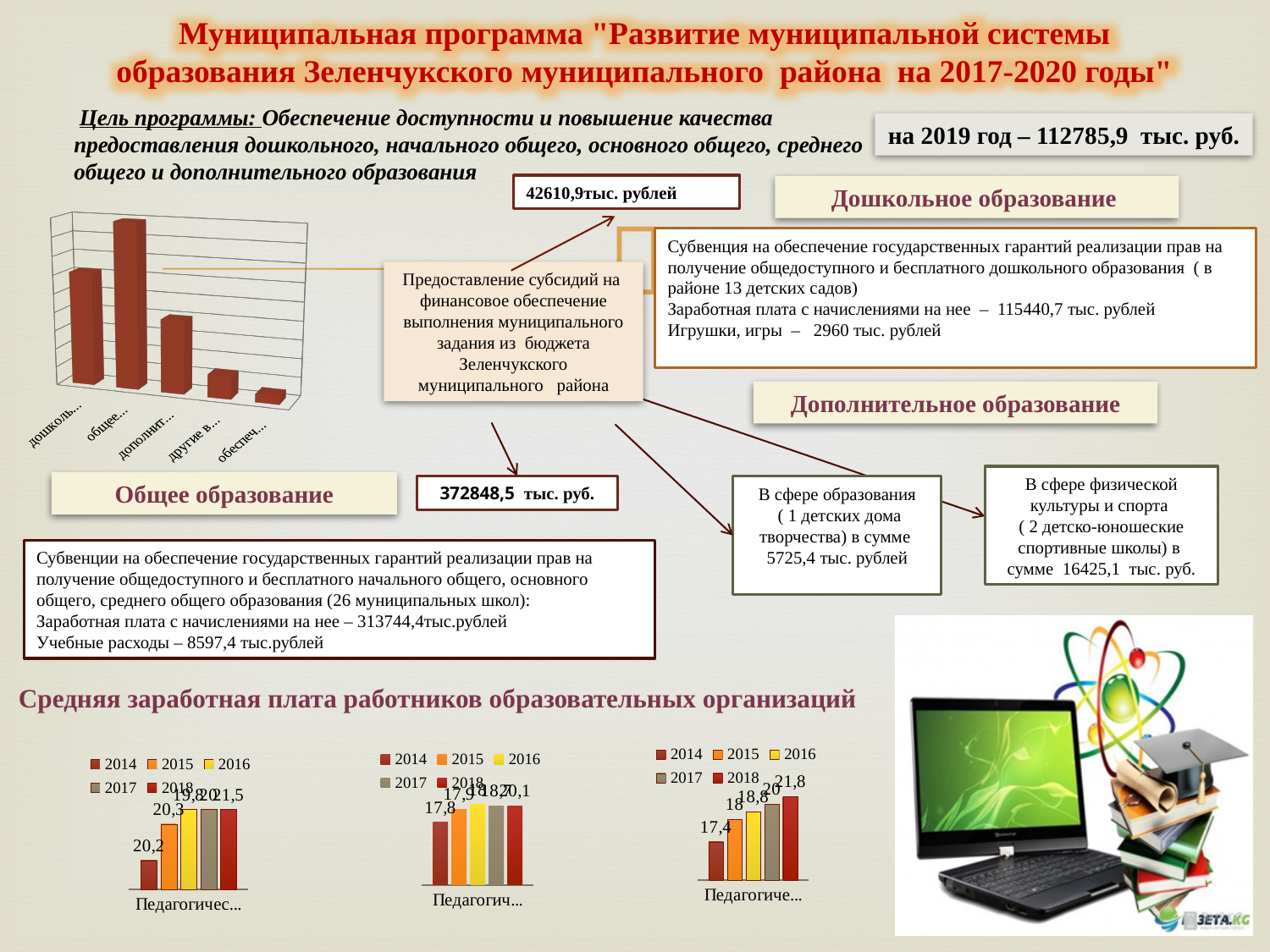
In the bottom-right small chart (third chart under 'Средняя заработная плата'), what is the value for 2018? 21,8 What is the heading printed above the three small bar charts at the bottom of the slide? Средняя заработная плата работников образовательных организаций In the bottom-right small chart (third chart under 'Средняя заработная плата'), which year has the highest value? 2018 How many series does the legend list in the bottom-right small chart (the third chart under 'Средняя заработная плата')? 5 In the large chart at the top left of the slide, is the second bar taller or shorter than the first bar? taller In the bottom-right small chart (third chart under 'Средняя заработная плата'), do the values rise or fall from 2014 to 2018? rise In the bottom-left small chart (first chart under 'Средняя заработная плата'), what is the value for 2014? 20,2 In the bottom-right small chart (third chart under 'Средняя заработная плата'), what is the value for 2014? 17,4 In the bottom-right small chart (third chart under 'Средняя заработная плата'), which year has the lowest value? 2014 In the bottom-right small chart (third chart under 'Средняя заработная плата'), what is the difference between the 2018 value and the 2014 value? 4,4 What kind of chart is the large chart at the top left of the slide? bar chart How many bars does the large chart at the top left of the slide show? 5